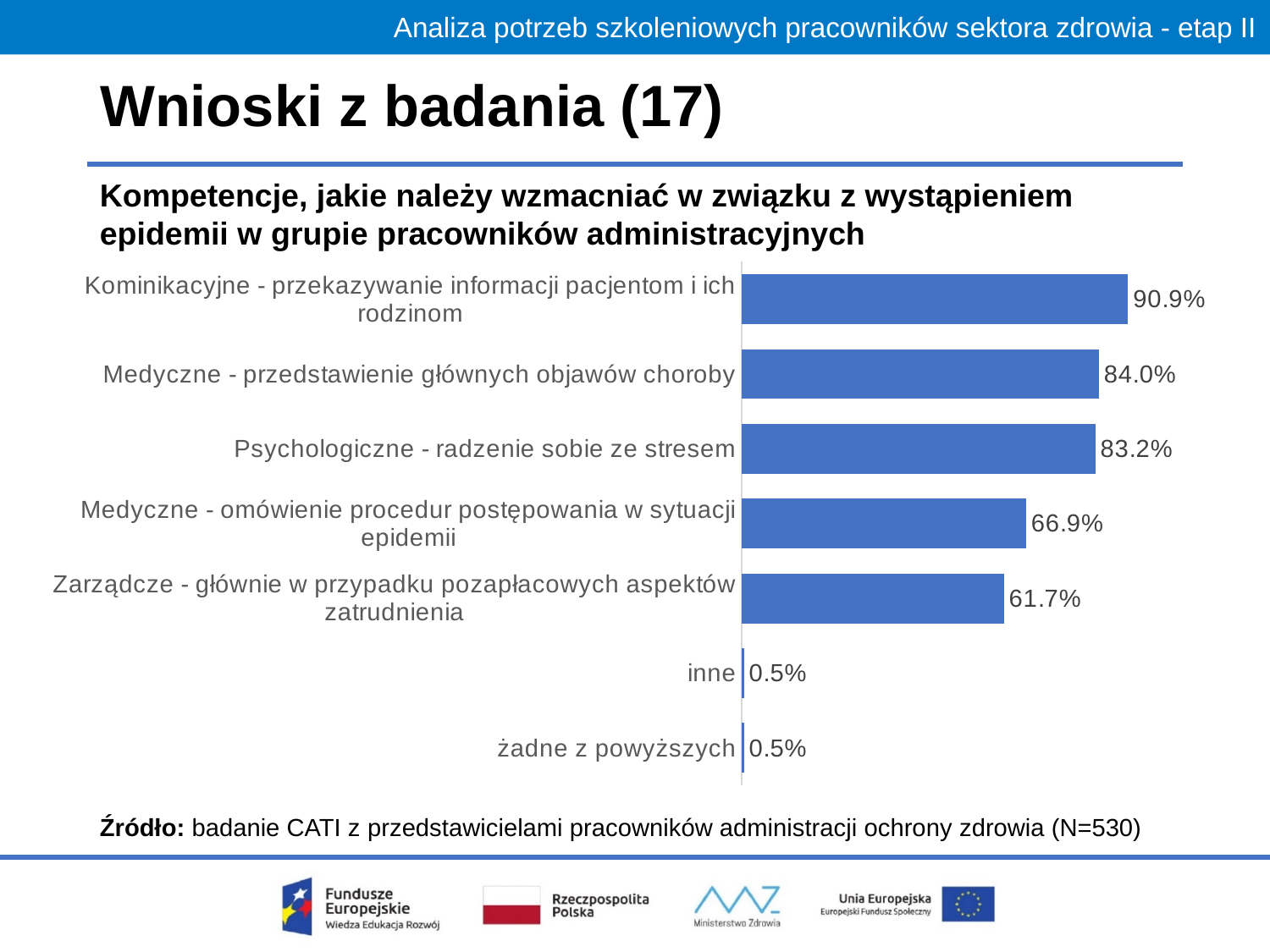
What value is shown for "Zarządcze - głównie w przypadku pozapłacowych aspektów zatrudnienia"? 61.7% How many categories are shown in the chart? 7 What is the sample size (N) given in the source note below the chart? N=530 Which category has the highest value? Kominikacyjne - przekazywanie informacji pacjentom i ich rodzinom What value is shown for "Medyczne - omówienie procedur postępowania w sytuacji epidemii"? 66.9% What value is shown for "Psychologiczne - radzenie sobie ze stresem"? 83.2% What is the highest value shown in the chart? 90.9% What value is shown for "inne"? 0.5% What is the difference between the values for "Medyczne - omówienie procedur postępowania w sytuacji epidemii" and "Zarządcze - głównie w przypadku pozapłacowych aspektów zatrudnienia"? 5.2% What kind of chart is shown on the slide? Bar chart Which is larger: the value for "Medyczne - przedstawienie głównych objawów choroby" or for "Psychologiczne - radzenie sobie ze stresem"? Medyczne - przedstawienie głównych objawów choroby What is the difference between the values for "Kominikacyjne - przekazywanie informacji pacjentom i ich rodzinom" and "Medyczne - przedstawienie głównych objawów choroby"? 6.9%